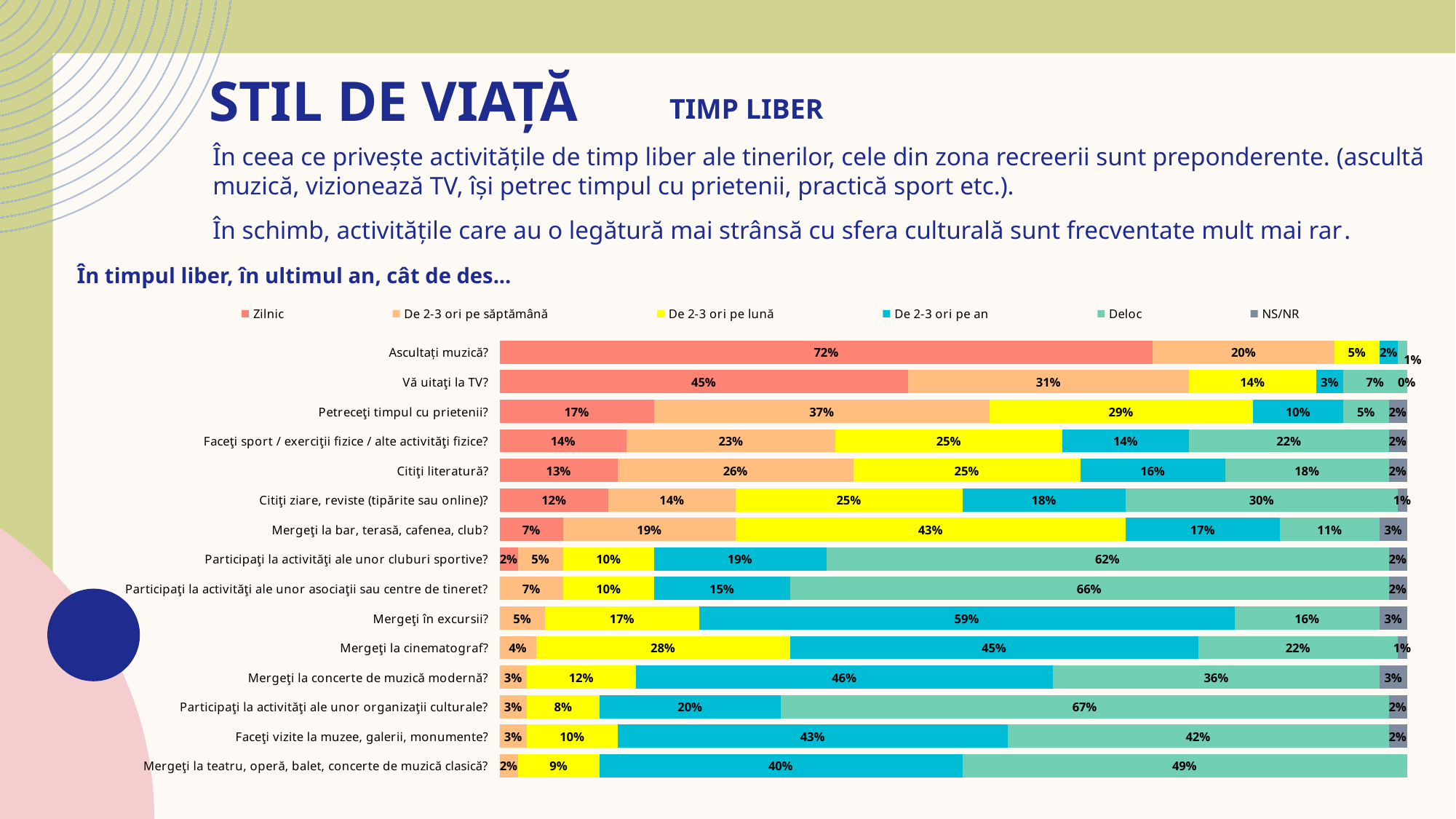
Which activity has the highest 'Zilnic' (daily) percentage? Ascultaţi muzică? What percentage of respondents listen to music daily (Zilnic) according to the chart? 72% What is the difference between the 'Zilnic' values for 'Ascultaţi muzică?' and 'Vă uitaţi la TV?' 27% What kind of chart is shown on the slide? Stacked bar chart Which activity has the highest 'Deloc' percentage? Participaţi la activităţi ale unor organizaţii culturale? What is the 'Deloc' value for 'Participaţi la activităţi ale unor asociaţii sau centre de tineret?' 66% Which is larger: the 'Deloc' value for 'Mergeţi la concerte de muzică modernă?' or for 'Faceţi vizite la muzee, galerii, monumente?' Faceţi vizite la muzee, galerii, monumente? How many series does the legend list? 6 How many activities (categories) are shown in the chart? 15 What is the 'De 2-3 ori pe an' value for 'Mergeţi în excursii?' 59% What is the title of the chart? În timpul liber, în ultimul an, cât de des… What is the 'De 2-3 ori pe lună' value for 'Mergeţi la bar, terasă, cafenea, club?' 43%